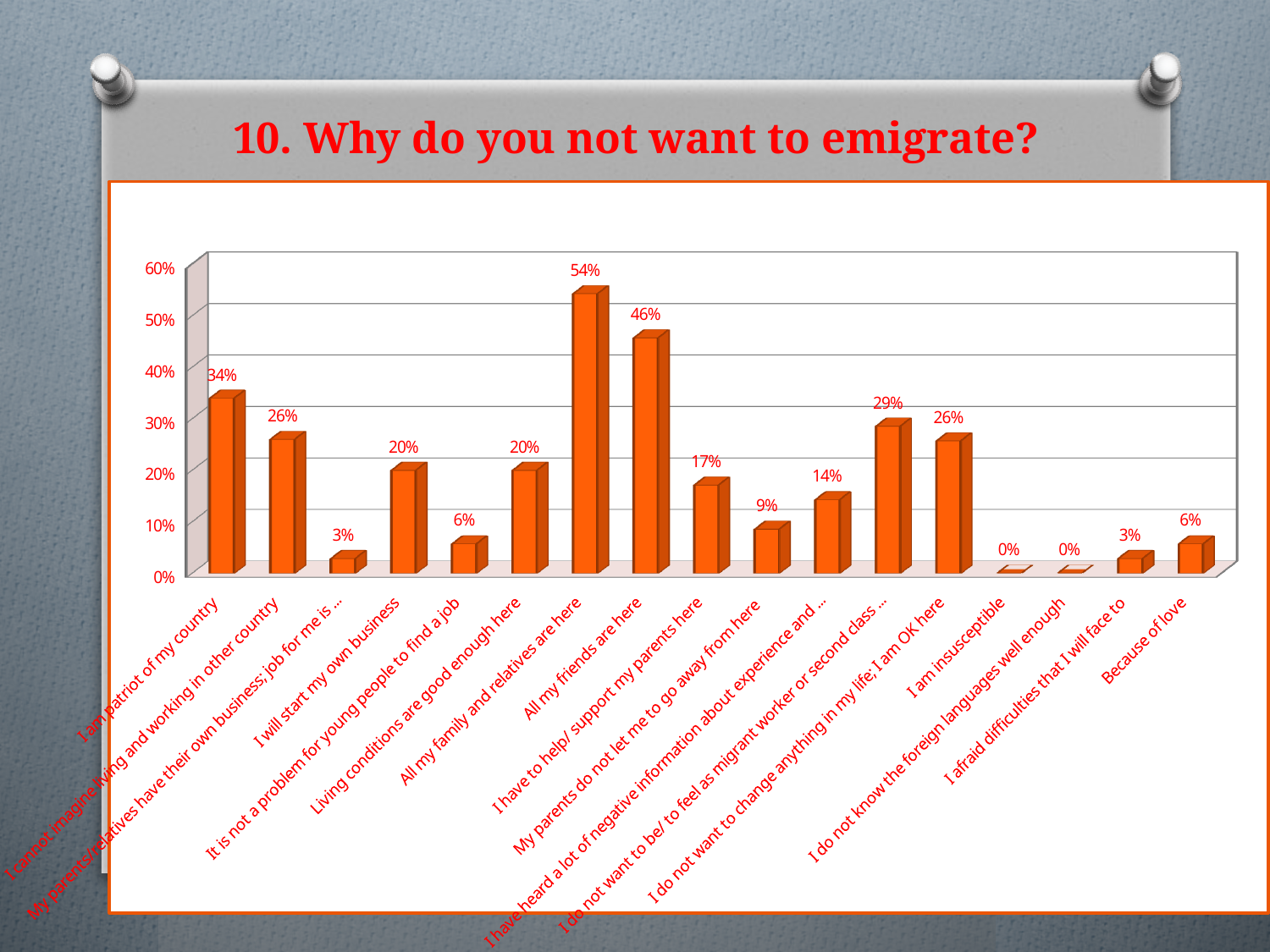
What is the value for "I am patriot of my country"? 34% How many reasons (bars) are shown in the chart? 17 What is the value for "I have to help/ support my parents here"? 17% What is the title of the slide? 10. Why do you not want to emigrate? What is the difference between "All my family and relatives are here" and "All my friends are here"? 8% What percentage is shown for "Because of love"? 6% Which is larger: the value for "I will start my own business" or the value for "My parents do not let me to go away from here"? I will start my own business Which reason has the highest percentage in the chart? All my family and relatives are here What percentage of respondents chose "All my family and relatives are here" as a reason not to emigrate? 54% Is the value for "I do not want to change anything in my life; I am OK here" greater or less than 20%? greater What kind of chart is shown on the slide? Bar chart What is the value for "I am insusceptible"? 0%